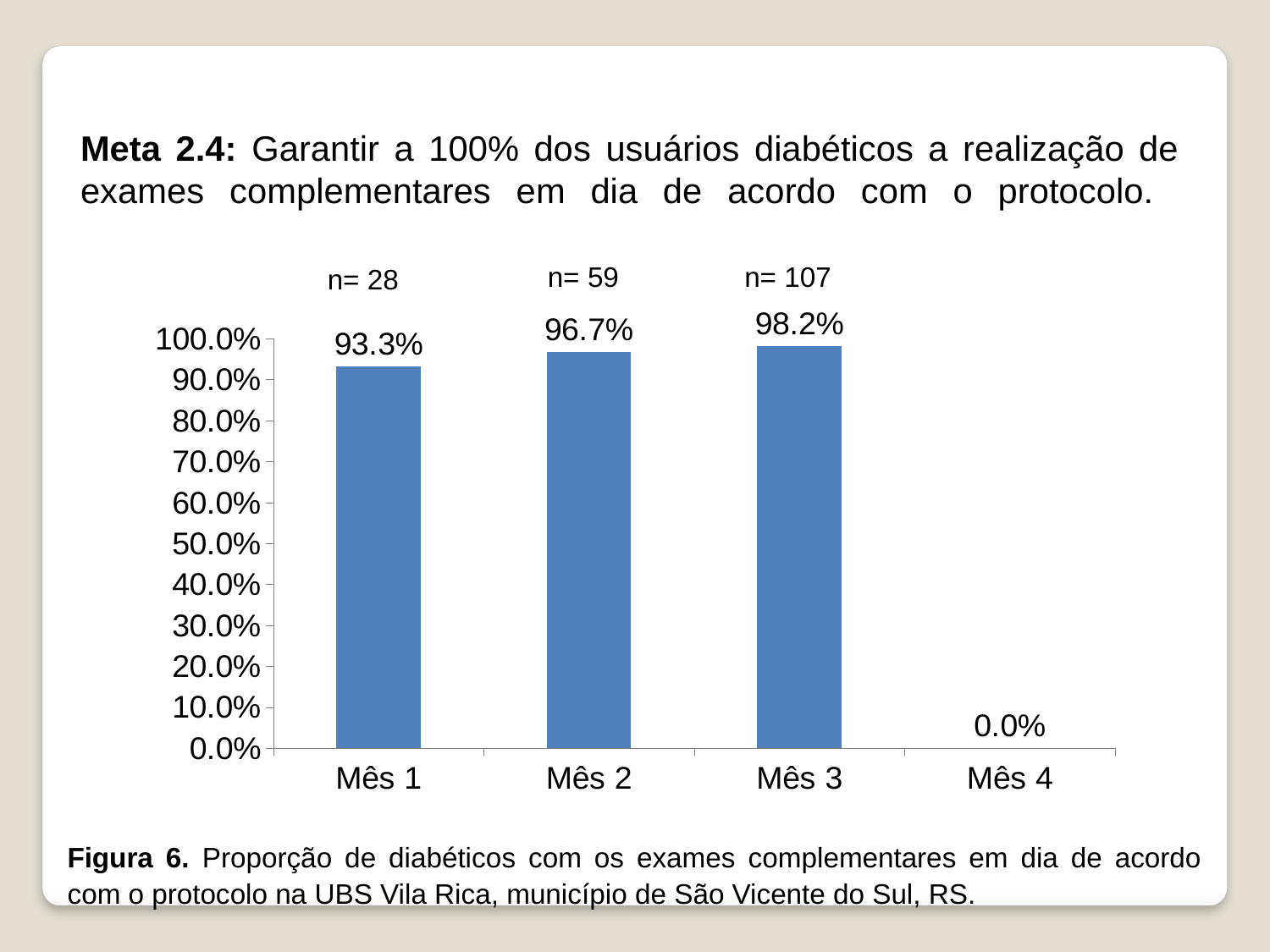
What kind of chart is this? Bar chart Which month has the lowest value? Mês 4 What is the n value shown above the bar for Mês 3? n= 107 Which is larger, the value for Mês 2 or the value for Mês 1? Mês 2 What is the value for Mês 3? 98.2% What is the value for Mês 4? 0.0% How many months are shown on the x axis? 4 Which month has the highest value? Mês 3 What is the difference between the values for Mês 3 and Mês 1? 4.9% Do the values rise or fall from Mês 1 to Mês 3? Rise What is the value for Mês 1? 93.3% What is the value for Mês 2? 96.7%